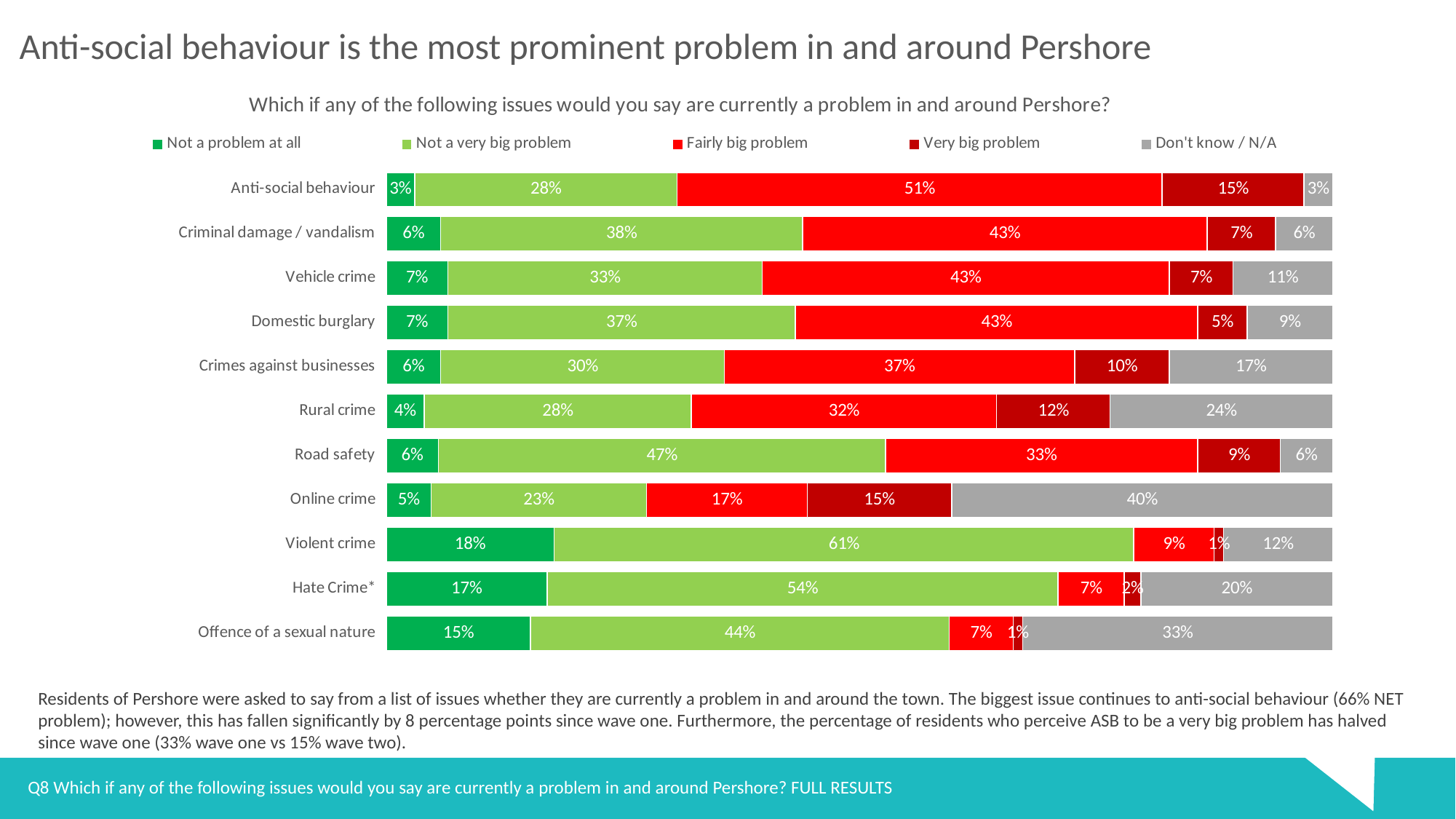
What is the difference between the 'Very big problem' percentages for anti-social behaviour and domestic burglary? 10 percentage points Which issue has the lowest 'Don't know / N/A' percentage? Anti-social behaviour What type of chart is shown on the slide? Stacked bar chart Which colour represents 'Don't know / N/A' in the legend? Grey Which has a larger 'Not a problem at all' percentage: violent crime or hate crime? Violent crime How many issues are listed in the chart? 11 Which issue has the highest 'Fairly big problem' percentage? Anti-social behaviour What percentage of respondents said anti-social behaviour is a fairly big problem? 51% What percentage of respondents answered 'Don't know / N/A' for online crime? 40% What percentage said violent crime is not a very big problem? 61% What is the combined percentage of 'Fairly big problem' and 'Very big problem' responses for anti-social behaviour? 66% How many response categories does the legend list? 5